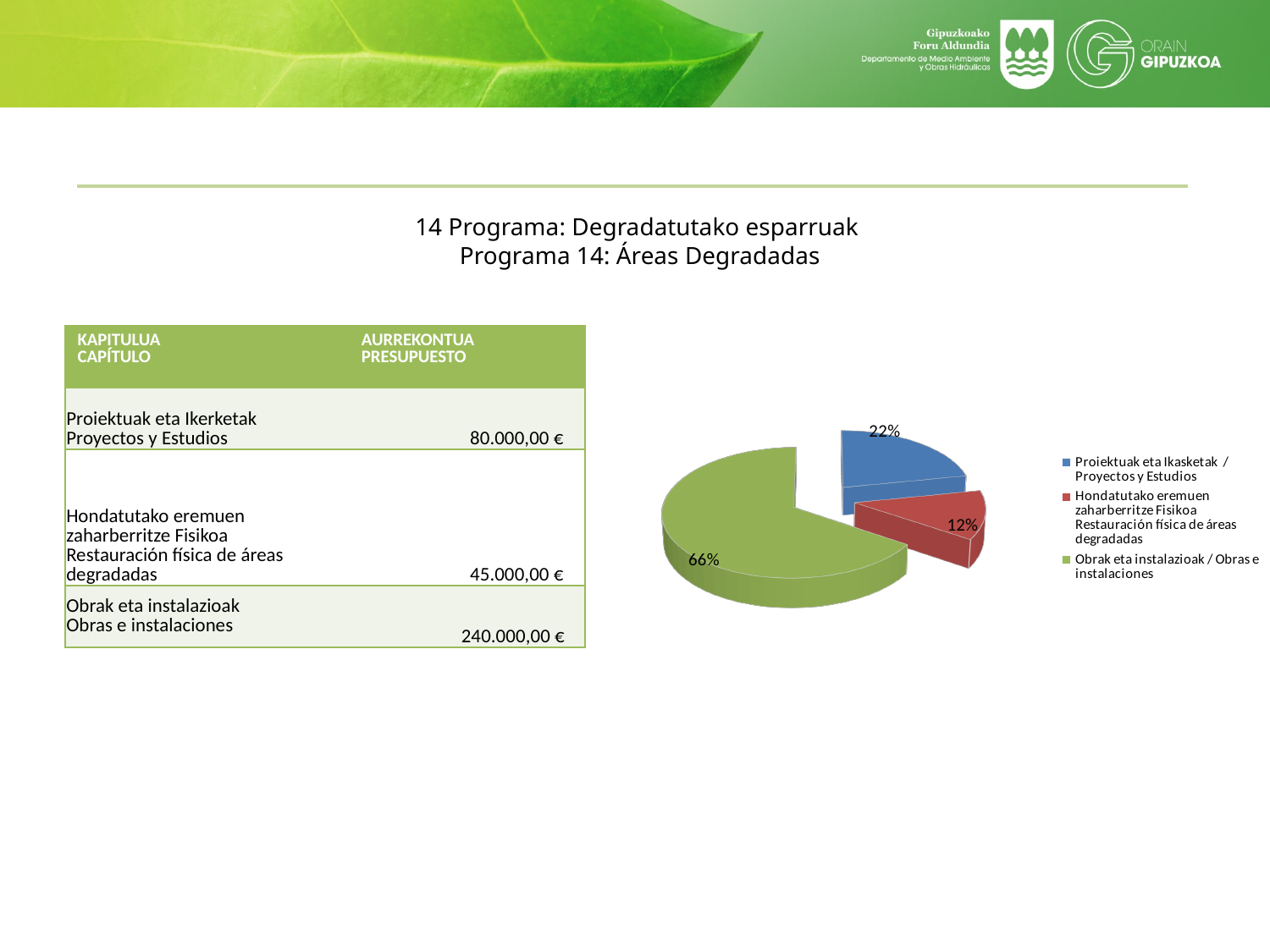
What share of the pie does the slice for Hondatutako eremuen zaharberritze Fisikoa / Restauración física de áreas degradadas represent? 12% What share of the pie does the slice for Obrak eta instalazioak / Obras e instalaciones represent? 66% How many entries does the pie chart's legend list? 3 What colour is the slice labelled 12% in the pie chart? red How many slices does the pie chart have? 3 What colour is the slice for Obrak eta instalazioak / Obras e instalaciones in the pie chart? green Which slice of the pie chart is the smallest? Hondatutako eremuen zaharberritze Fisikoa / Restauración física de áreas degradadas Which slice of the pie chart is the largest? Obrak eta instalazioak / Obras e instalaciones What kind of chart is shown on the slide? pie chart What is the difference in percentage points between the largest slice (66%) and the smallest slice (12%) of the pie chart? 54 Which is larger in the pie chart: the slice for Proiektuak eta Ikasketak / Proyectos y Estudios or the slice for Hondatutako eremuen zaharberritze Fisikoa / Restauración física de áreas degradadas? Proiektuak eta Ikasketak / Proyectos y Estudios What share of the pie does the slice for Proiektuak eta Ikasketak / Proyectos y Estudios represent? 22%